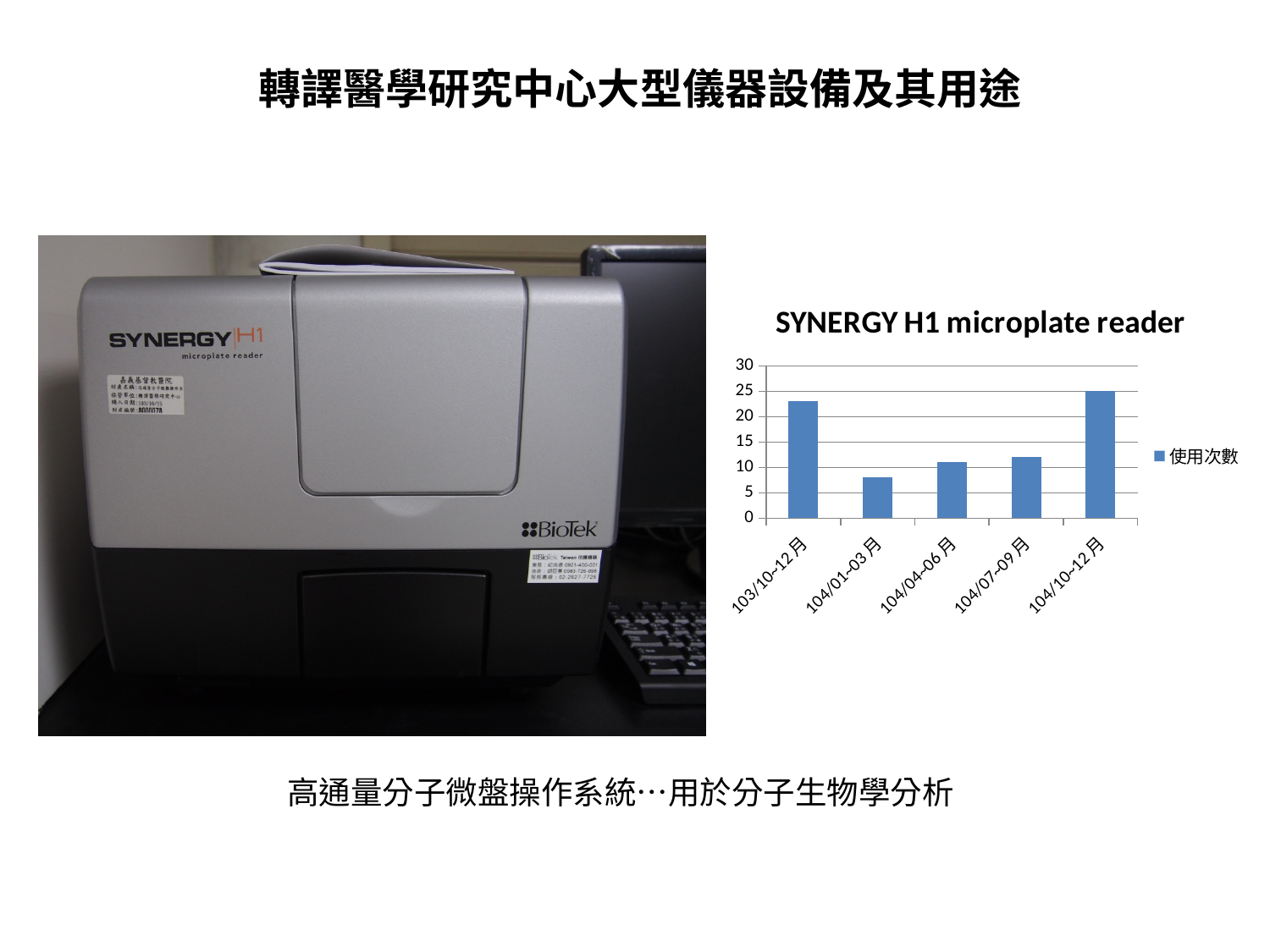
What is the title of the chart on the slide? SYNERGY H1 microplate reader Is the value for 104/10~12月 greater or less than 20? greater What is the name of the series shown in the chart's legend? 使用次數 Is the value for 104/01~03月 greater or less than 10? less Is the value for 103/10~12月 greater or less than 20? greater Which is larger, the value for 103/10~12月 or the value for 104/01~03月? 103/10~12月 Which category has the lowest value in the chart? 104/01~03月 Which category has the highest value in the chart? 104/10~12月 How many categories are shown on the x axis of the chart? 5 How many series does the chart's legend list? 1 What kind of chart is shown on the slide? bar chart